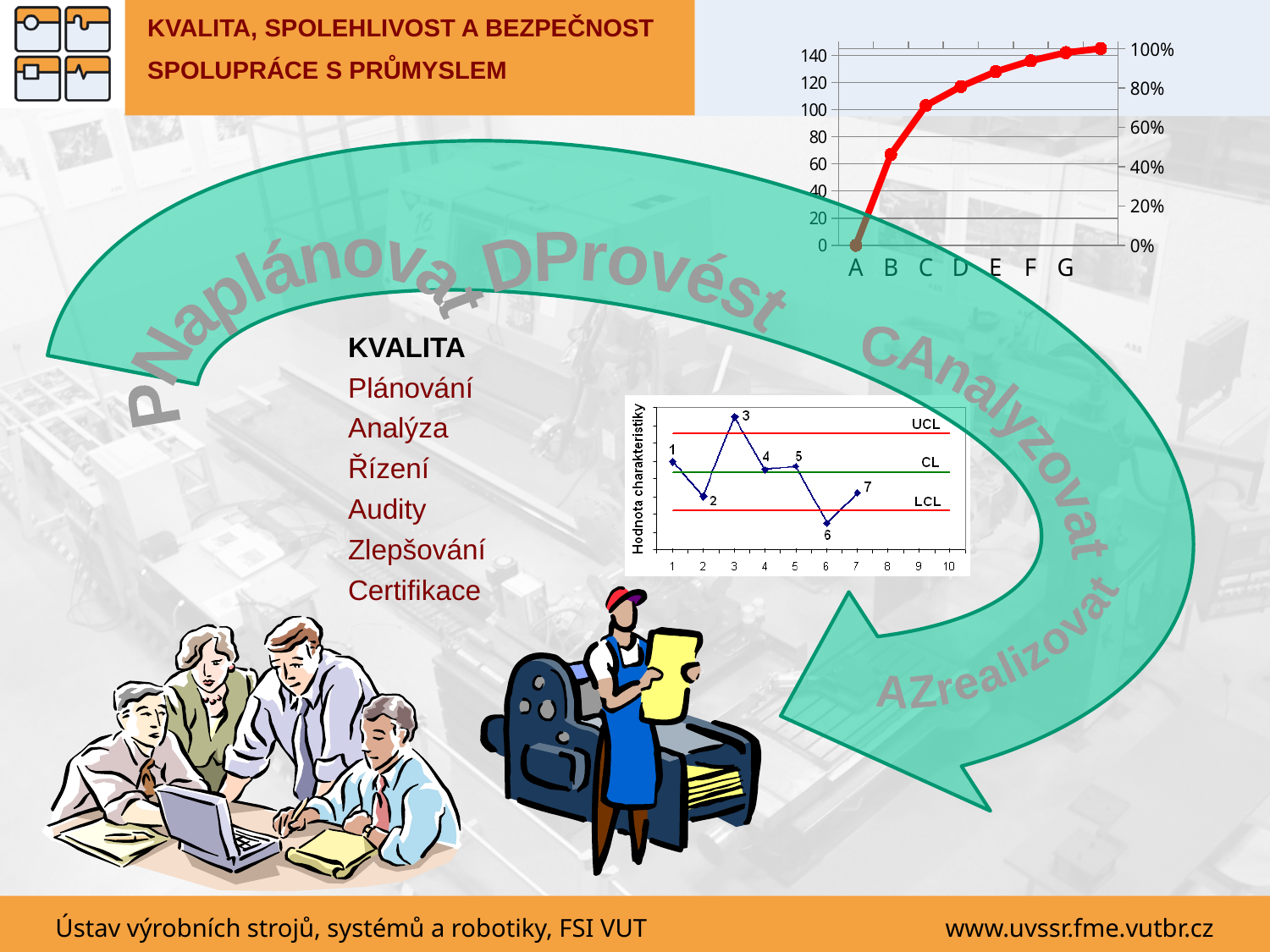
In the top-right chart, is the value for E greater or less than 120 on the left axis? greater In the top-right chart, is the value for B greater or less than 60 on the left axis? greater In the top-right chart, how many categories are shown on the x axis? 7 In the control chart in the middle of the slide, which point lies below the LCL line? 6 In the top-right chart, do the values rise or fall from A to G? rise In the control chart in the middle of the slide, what is the label of the vertical axis? Hodnota charakteristiky In the control chart in the middle of the slide, how many data points are plotted? 7 In the control chart in the middle of the slide, which point lies above the UCL line? 3 In the top-right chart, what kind of chart is it? line chart In the top-right chart, which category has the lowest value? A In the top-right chart, which category has the highest value? G